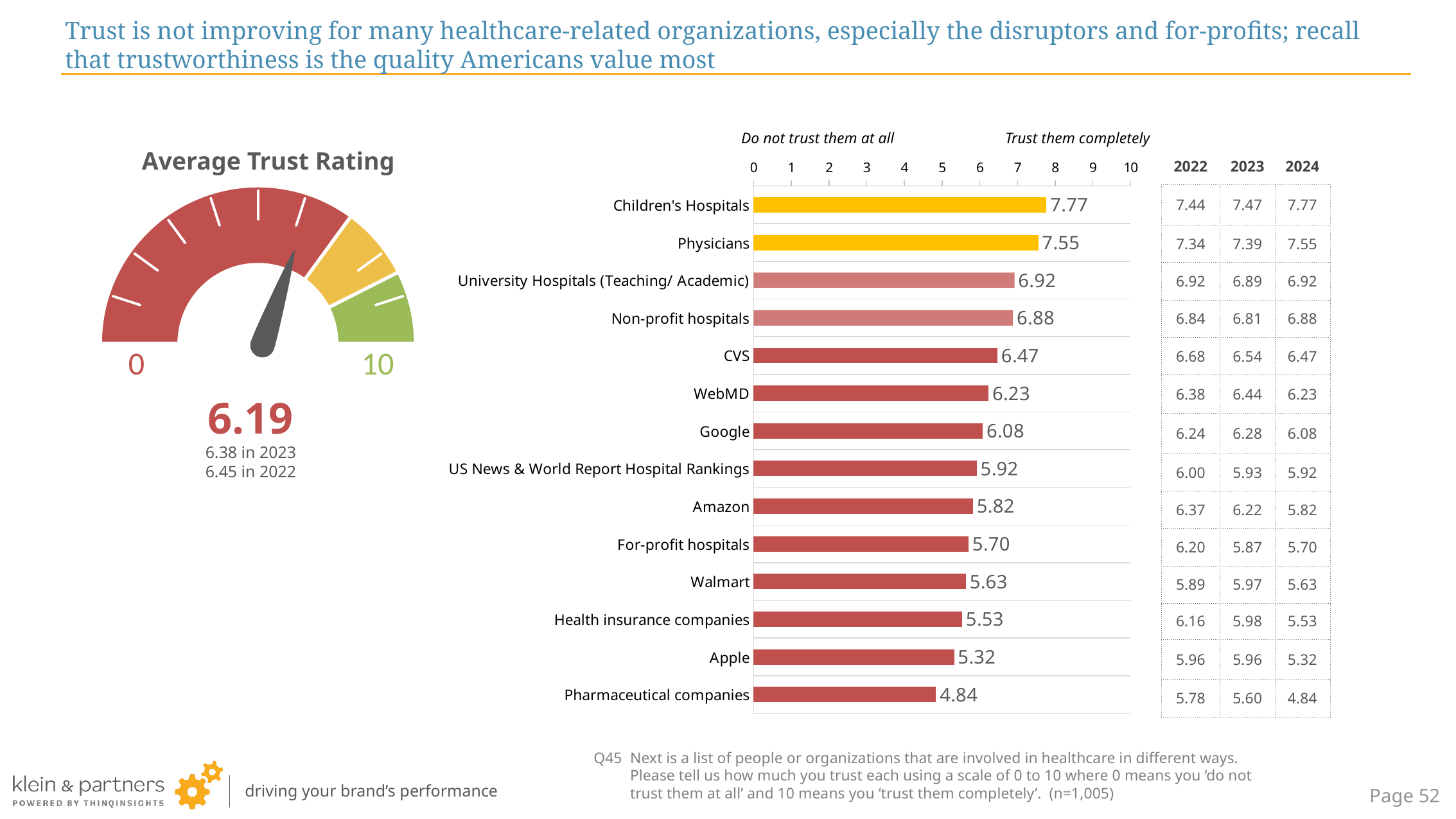
What value does the Average Trust Rating gauge on the left show? 6.19 In the bar chart on the right, what is the trust rating for Pharmaceutical companies? 4.84 According to the text under the Average Trust Rating gauge, what was the average trust rating in 2023? 6.38 In the table next to the bar chart, what was the trust rating for Google in 2022? 6.24 In the bar chart on the right, which has a higher trust rating, Amazon or Walmart? Amazon In the bar chart on the right, what is the difference between the trust ratings for Children's Hospitals and Physicians? 0.22 In the bar chart on the right, what is the trust rating for CVS? 6.47 In the bar chart on the right, is the trust rating for Apple greater or less than 6? less In the bar chart on the right, which organization has the lowest trust rating? Pharmaceutical companies What kind of chart is shown on the right side of the slide? Bar chart How many organizations are listed in the bar chart on the right? 14 In the bar chart on the right, which organization has the highest trust rating? Children's Hospitals